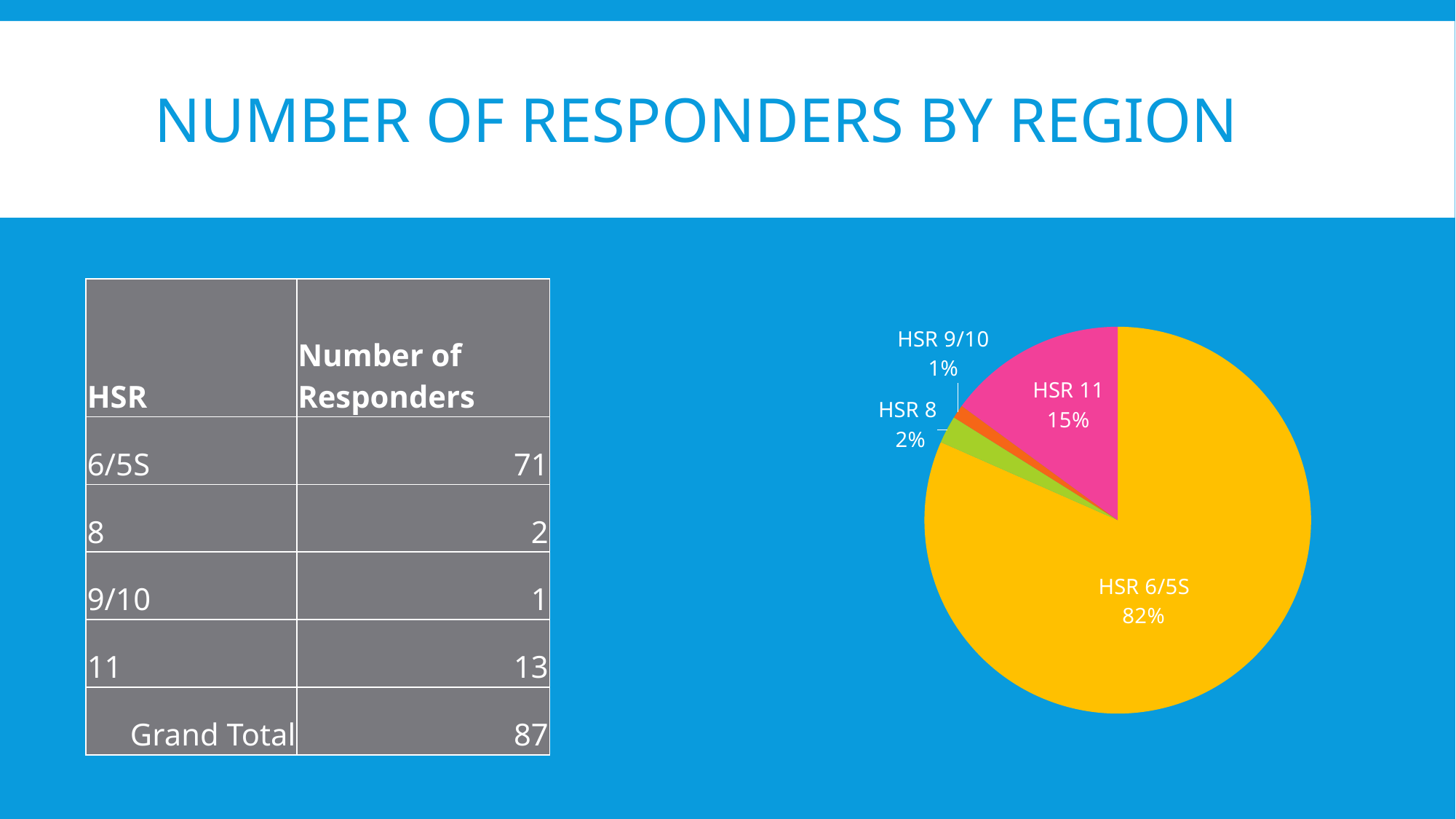
Which region has the smallest slice of the pie? HSR 9/10 What share of the pie does HSR 9/10 represent? 1% What share of the pie does HSR 6/5S represent? 82% Which region has the largest slice of the pie? HSR 6/5S What share of the pie does HSR 11 represent? 15% What is the difference in percentage points between the HSR 6/5S slice and the HSR 11 slice? 67 Which slice is larger, HSR 11 or HSR 8? HSR 11 What colour is the HSR 11 slice? pink What colour is the HSR 6/5S slice? yellow How many slices does the pie chart have? 4 What kind of chart is shown on the slide? pie chart